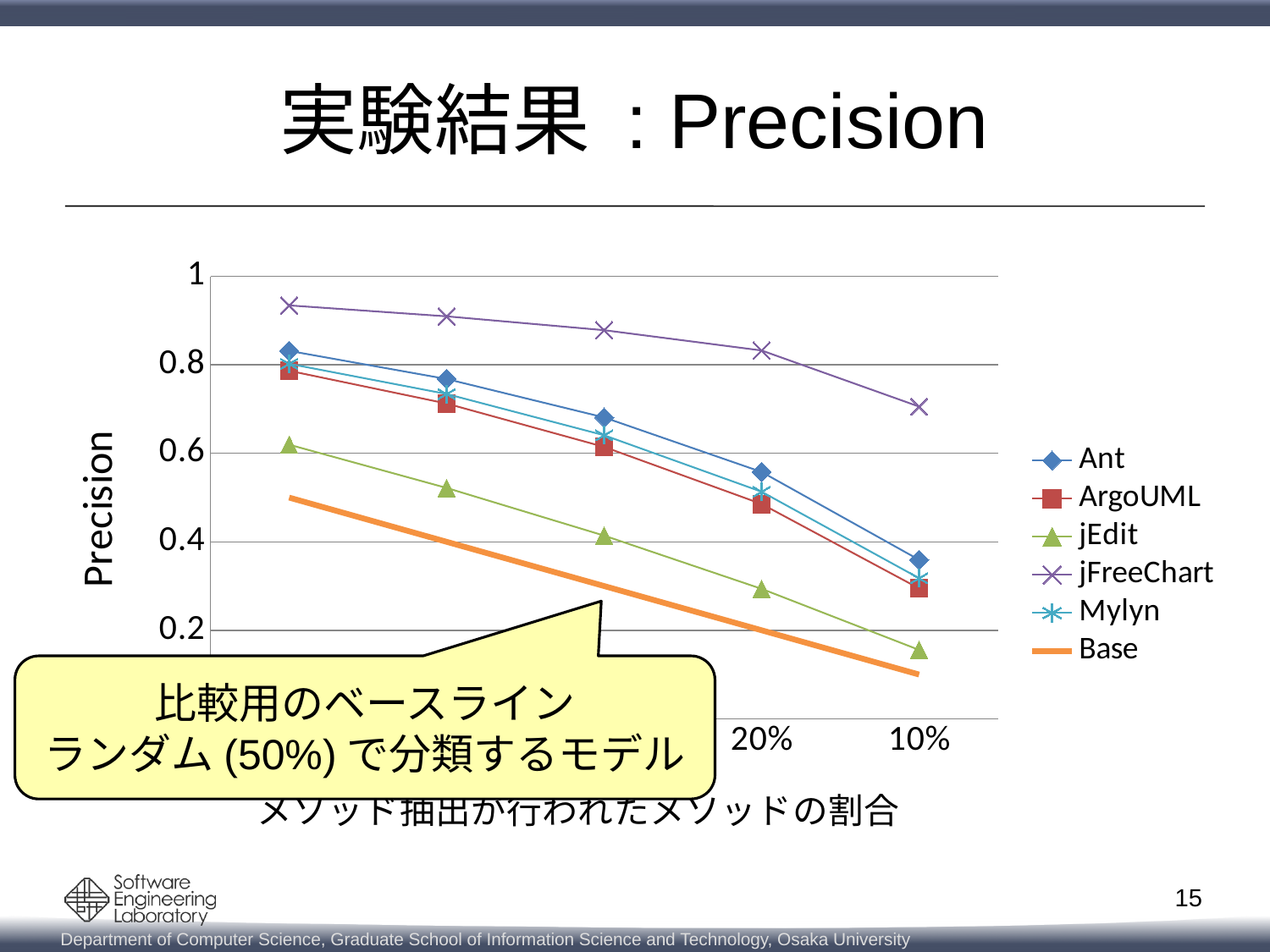
Is the Precision for jEdit at 10% greater or less than 0.2? less Which series has the highest Precision at the 20% category? jFreeChart How many data points does the Ant series have? 5 Which series has the highest Precision at the 10% category? jFreeChart How many series does the legend list? 6 What kind of chart is shown on the slide? line chart At the 20% category, which is larger: the Precision for jFreeChart or for jEdit? jFreeChart Which series has the lowest Precision at the 10% category? Base What is the label of the vertical axis? Precision Is the Precision for jFreeChart at 10% greater or less than 0.8? less Is the Precision for Ant at 20% greater or less than 0.4? greater Do the Precision values for the Ant series rise or fall from left to right along the x axis? fall